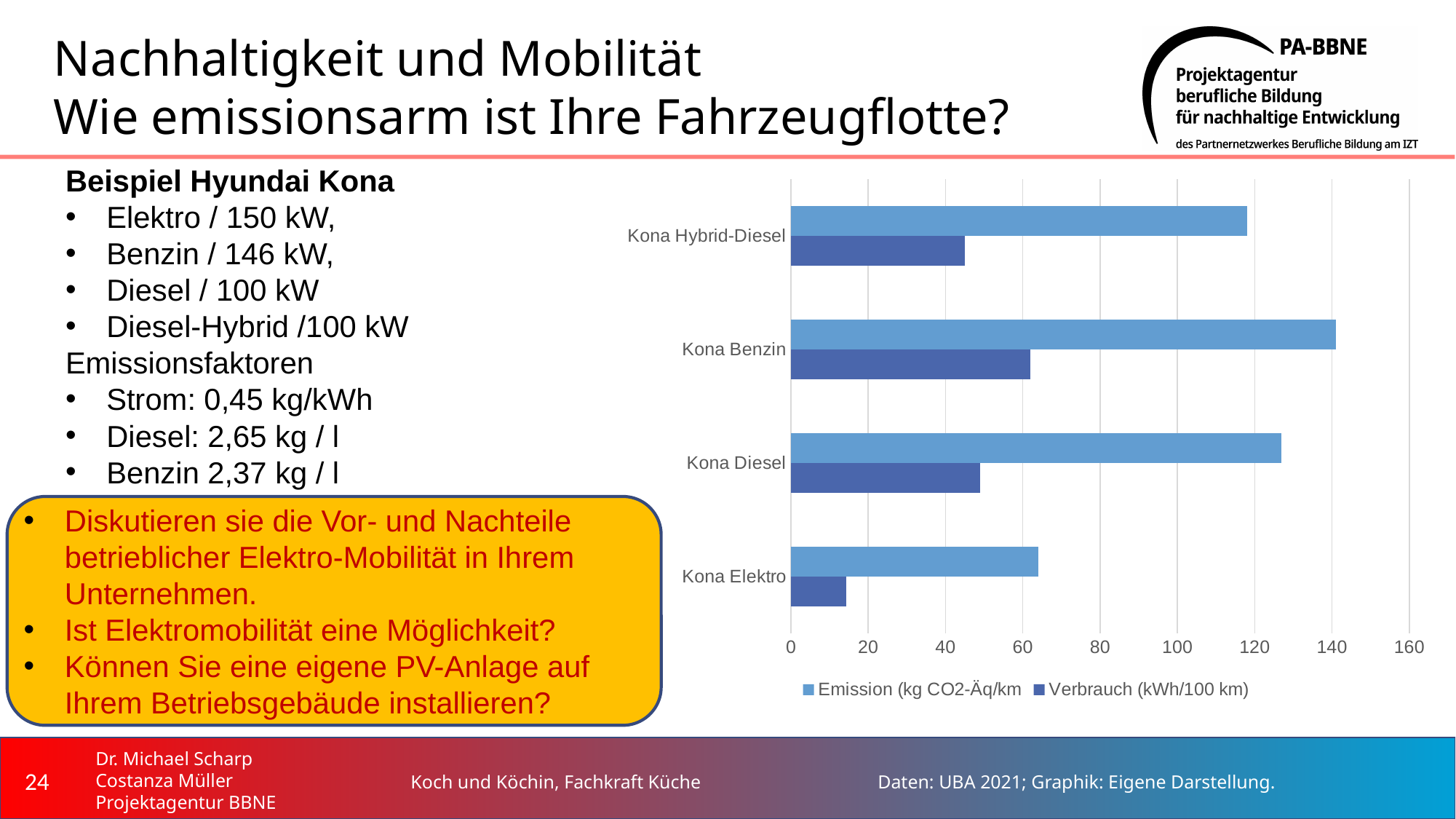
Which category has the highest Verbrauch (kWh/100 km) value? Kona Benzin Is the Emission value for Kona Elektro greater or less than 80? less How many vehicle categories are shown in the chart? 4 What kind of chart is shown on the slide? bar chart What is the name of the second series in the chart legend? Verbrauch (kWh/100 km) Is the Verbrauch value for Kona Elektro greater or less than 20? less How many series does the chart legend list? 2 Which category has the lowest Emission (kg CO2-Äq/km) value? Kona Elektro Which has the larger Emission value, Kona Diesel or Kona Hybrid-Diesel? Kona Diesel Which category has the lowest Verbrauch (kWh/100 km) value? Kona Elektro Which category has the highest Emission (kg CO2-Äq/km) value? Kona Benzin Is the Emission value for Kona Benzin greater or less than 120? greater